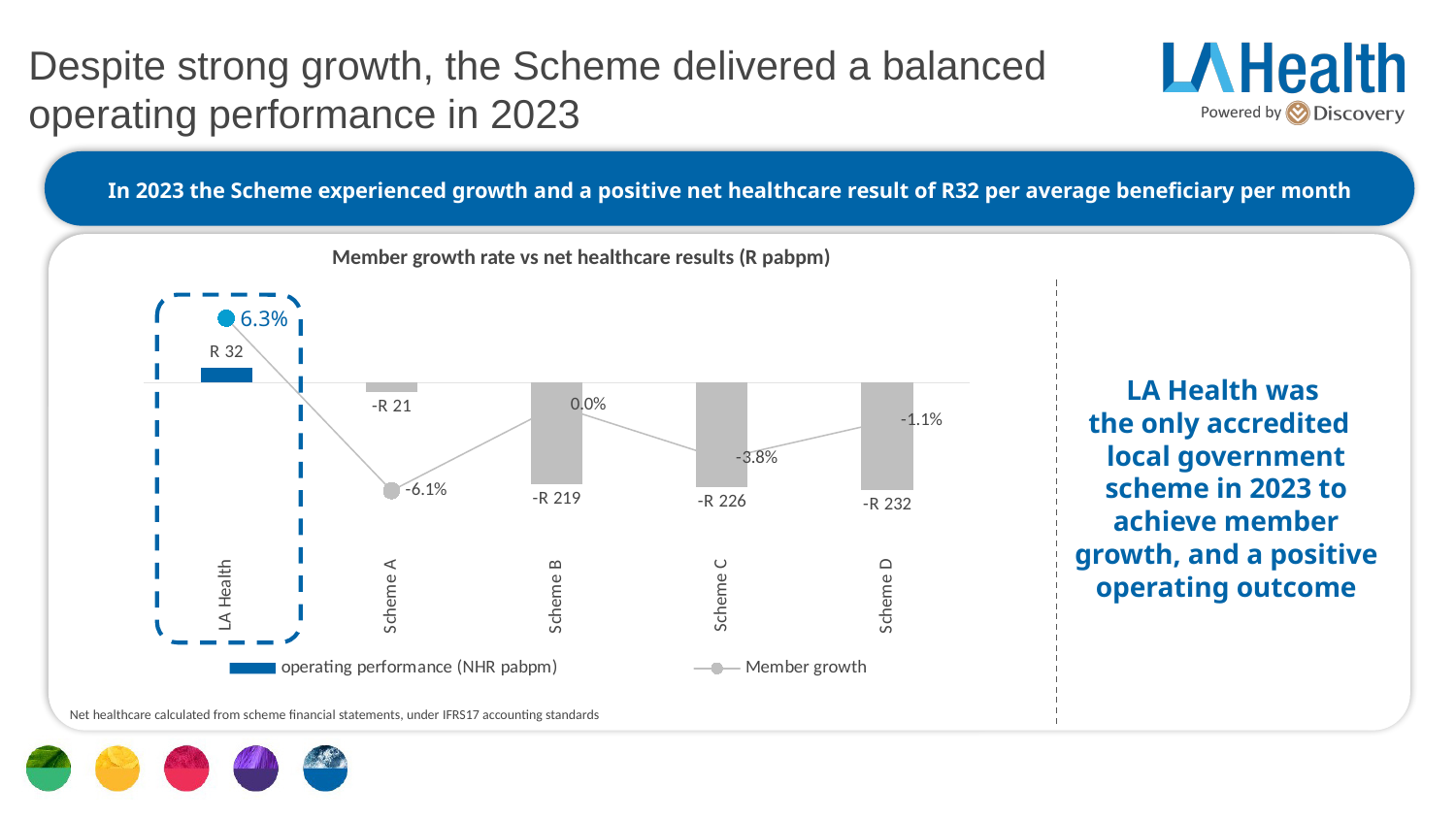
Which scheme has the lowest operating performance (NHR pabpm)? Scheme D How many series does the chart legend list? 2 Is the operating performance (NHR pabpm) for Scheme B larger than that for Scheme C? Yes Which scheme has the highest member growth rate? LA Health What is the operating performance (NHR pabpm) value for LA Health? R 32 How many schemes are shown on the x axis of the chart? 5 Which scheme has the lowest member growth rate? Scheme A What is the difference in member growth rate between LA Health and Scheme A? 12.4 percentage points What is the title of the chart? Member growth rate vs net healthcare results (R pabpm) What is the member growth rate for Scheme A? -6.1% What is the operating performance (NHR pabpm) value for Scheme D? -R 232 What is the member growth rate for Scheme C? -3.8%